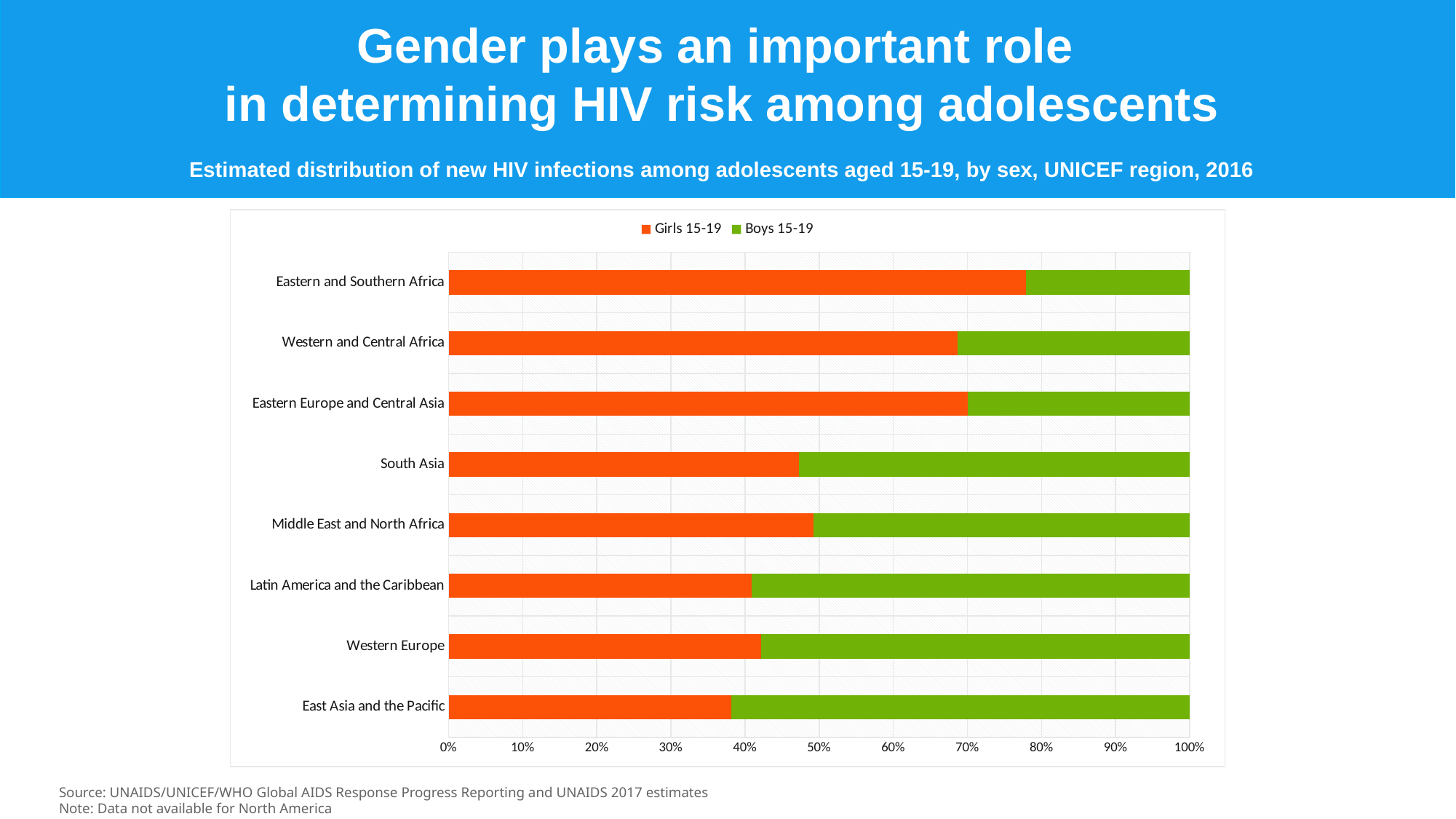
Is the Girls 15-19 share for South Asia greater or less than 50%? less What kind of chart is shown on the slide? Bar chart (stacked) Is the Boys 15-19 share for Western Europe greater or less than 50%? greater Which region has the highest share of new HIV infections among boys 15-19? East Asia and the Pacific Which region has the lowest share of new HIV infections among girls 15-19? East Asia and the Pacific Is the Girls 15-19 share for Western and Central Africa greater or less than 60%? greater How many regions are plotted on the chart? 8 Which region has the highest share of new HIV infections among girls 15-19? Eastern and Southern Africa Which region has a larger Girls 15-19 share: Eastern and Southern Africa or Western and Central Africa? Eastern and Southern Africa Which colour represents Girls 15-19 in the legend? Orange How many series does the legend list? 2